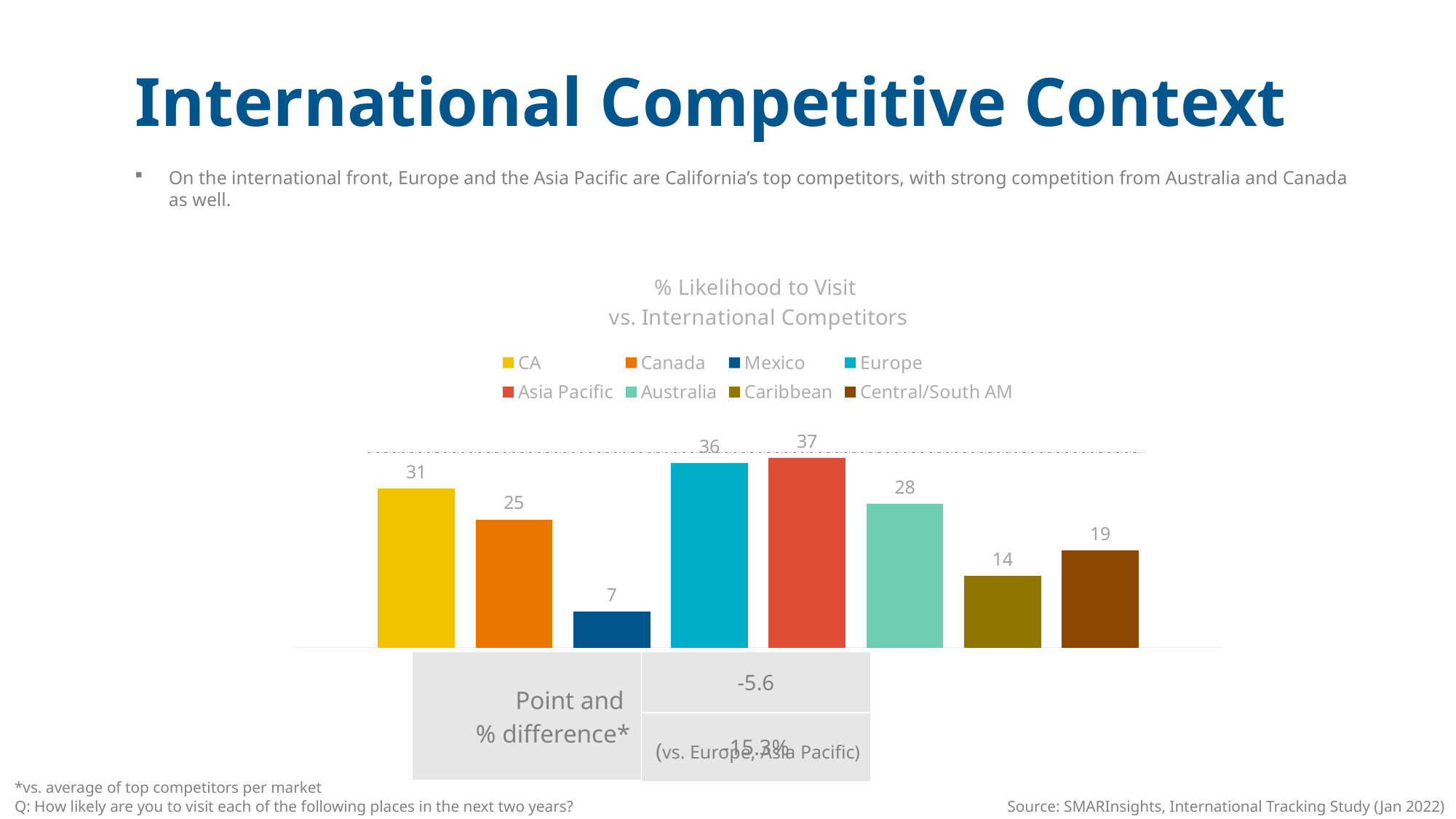
What is the difference between the values for Australia and Caribbean? 14 What is the value shown for Mexico? 7 What is the title of the chart? % Likelihood to Visit vs. International Competitors What is the difference between the values for Asia Pacific and CA? 6 Which has a higher value, Canada or Central/South AM? Canada Which destination has the lowest % likelihood to visit? Mexico What is the % likelihood to visit value for CA? 31 What is the value shown for Europe? 36 What type of chart is shown on the slide? Bar chart How many entries does the legend list? 8 How many destinations are plotted in the chart? 8 Which destination has the highest % likelihood to visit? Asia Pacific